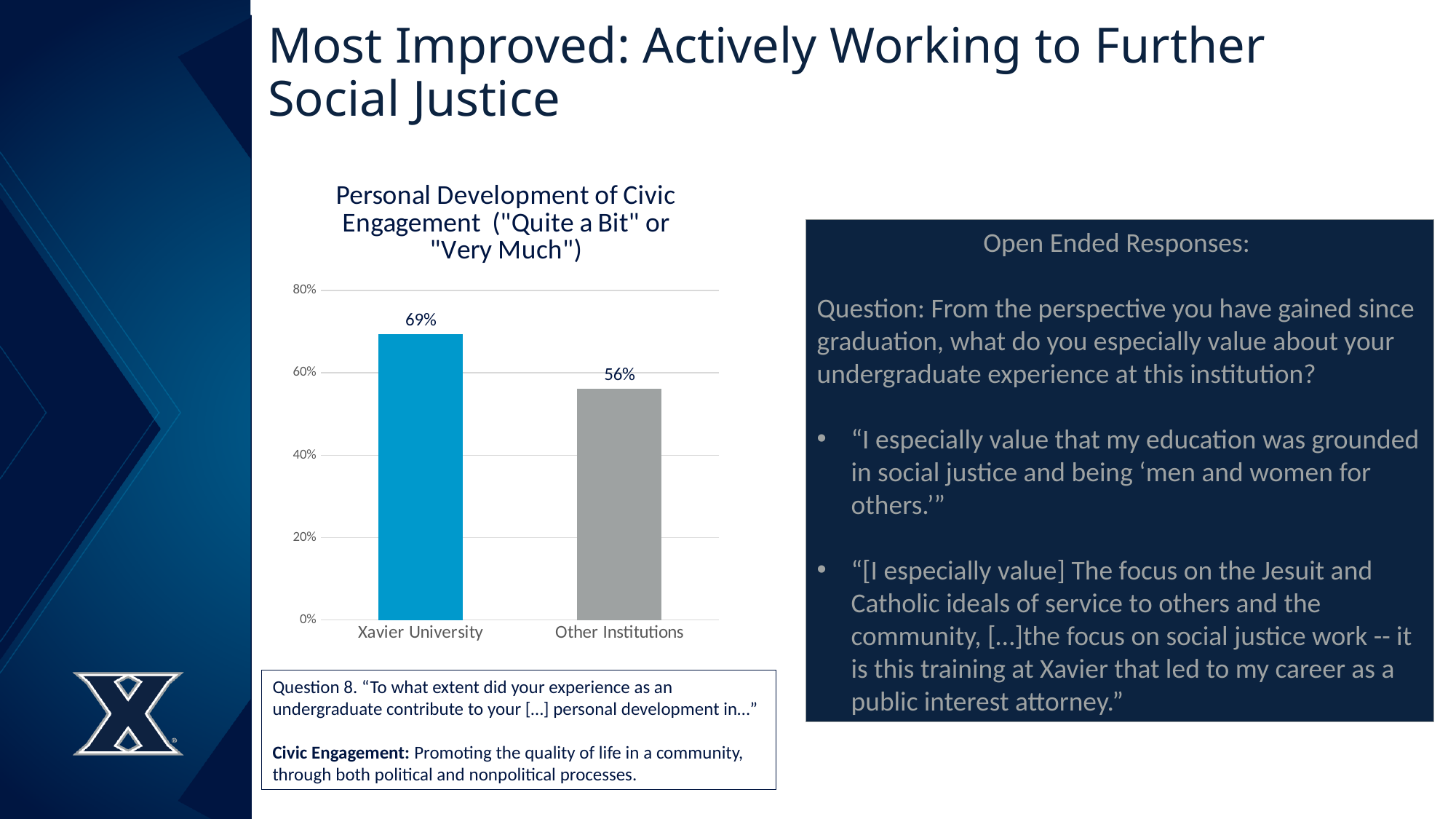
Is the value for Xavier University greater or less than 60%? greater Which is larger, the value for Xavier University or the value for Other Institutions? Xavier University What is the title of the chart? Personal Development of Civic Engagement ("Quite a Bit" or "Very Much") What is the value for Other Institutions? 56% What colour is the bar for Xavier University? Blue What is the value for Xavier University? 69% What kind of chart is shown on the slide? Bar chart Which category has the highest value? Xavier University Is the value for Other Institutions greater or less than 60%? less Which category has the lowest value? Other Institutions What is the difference between the values for Xavier University and Other Institutions? 13% How many categories are shown on the chart? 2